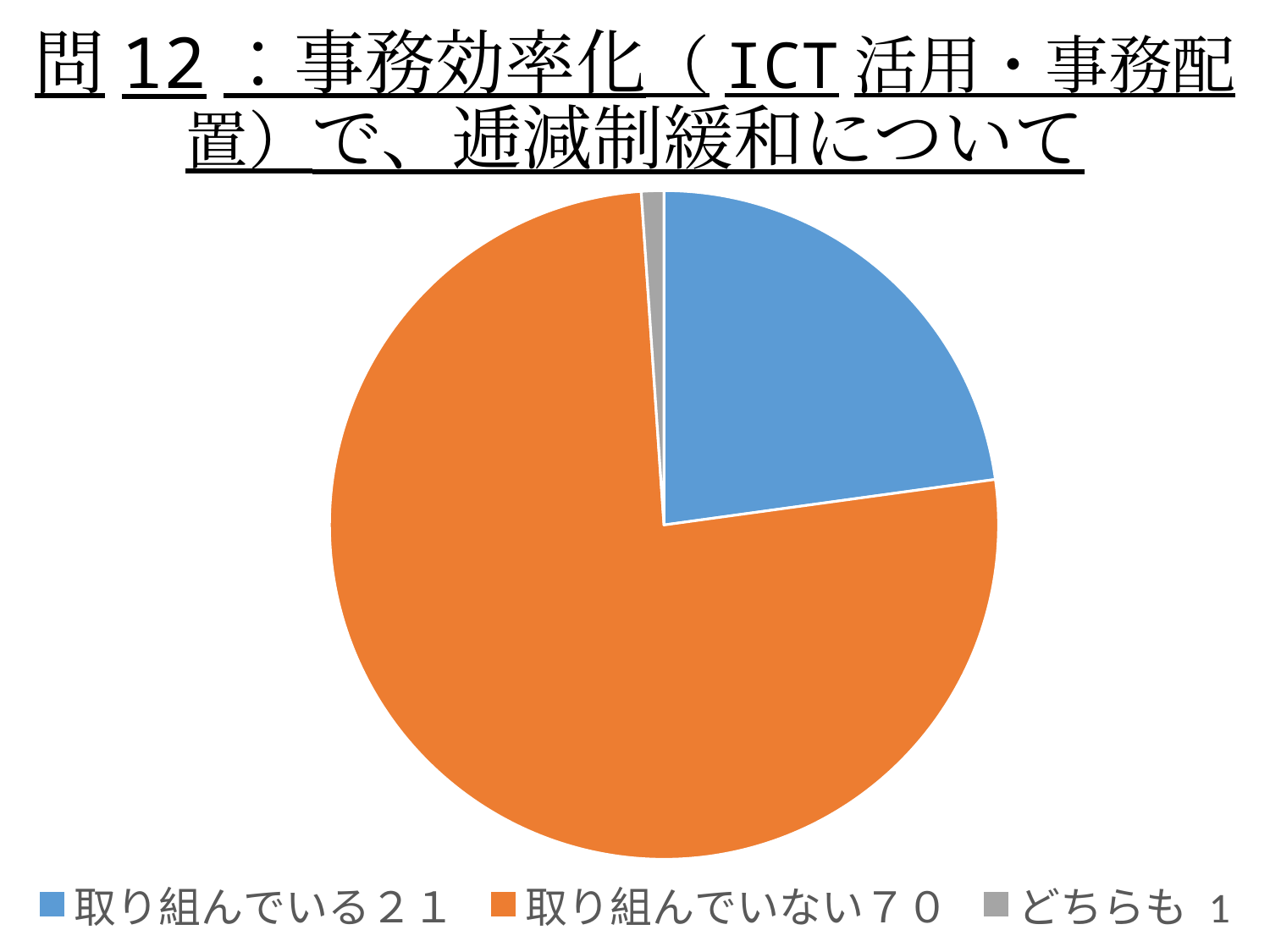
What is the value for どちらも in the pie chart? 1 How many categories does the pie chart have? 3 Which is larger, the value for 取り組んでいる or the value for どちらも? 取り組んでいる What is the value for 取り組んでいない in the pie chart? 70 Which category has the largest slice of the pie chart? 取り組んでいない Which category has the smallest slice of the pie chart? どちらも Which category is shown in blue in the pie chart? 取り組んでいる What is the difference between the values for 取り組んでいない and 取り組んでいる? 49 What is the value for 取り組んでいる in the pie chart? 21 What is the total of all three values in the pie chart? 92 What kind of chart is shown on the slide? pie chart What colour is the slice for 取り組んでいない? orange